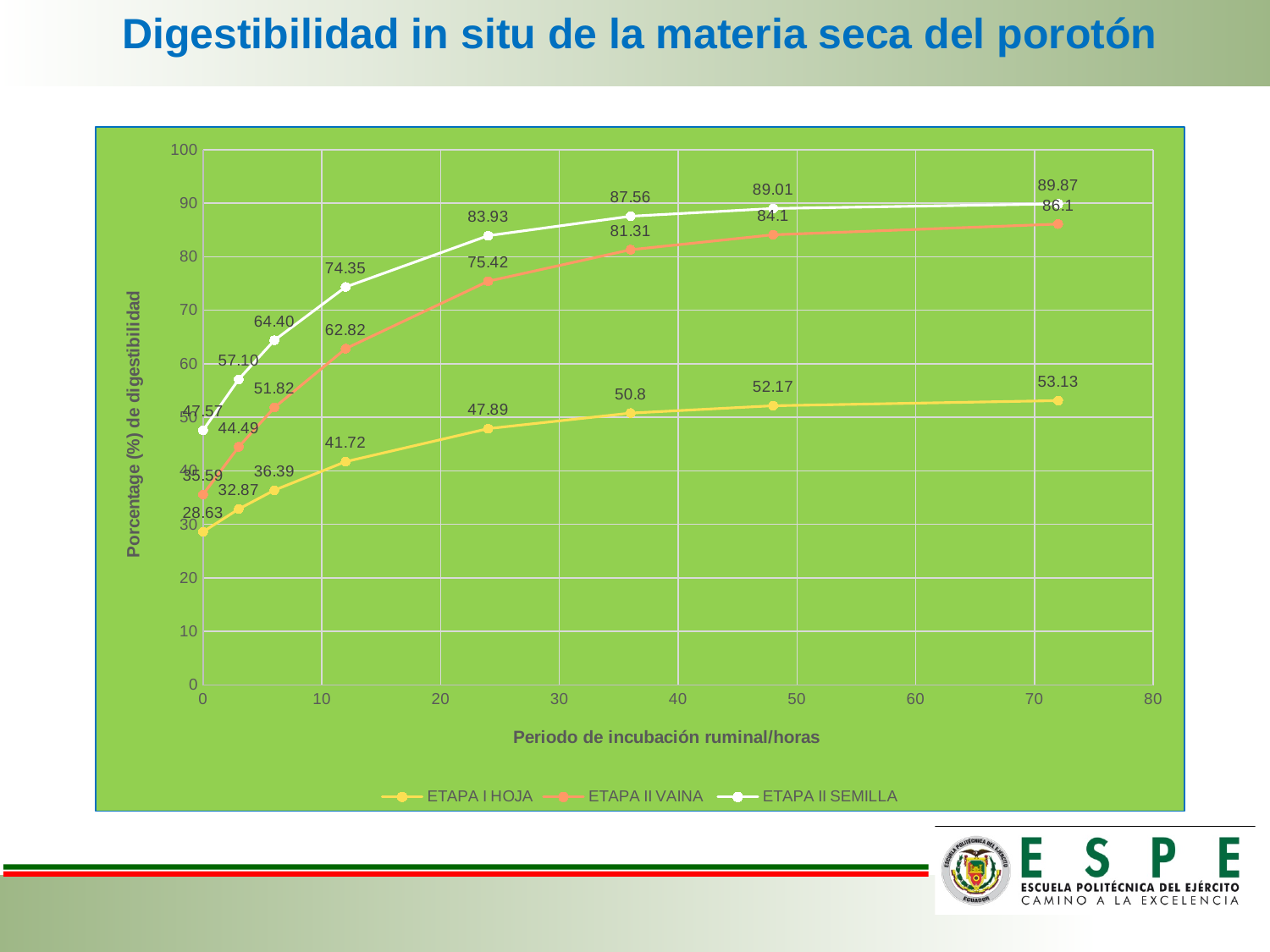
What is the value of ETAPA I HOJA at 0 hours of incubation? 28.63 At 0 hours, what is the difference between ETAPA II SEMILLA (47.57) and ETAPA I HOJA (28.63)? 18.94 Which series reaches the highest digestibility at the rightmost point? ETAPA II SEMILLA At 0 hours, which is larger: ETAPA II VAINA or ETAPA I HOJA? ETAPA II VAINA What type of chart is shown on the slide? line chart Do the values of ETAPA I HOJA rise or fall as the incubation period increases? rise What is the value of ETAPA II SEMILLA at 0 hours of incubation? 47.57 What is the title of the x axis? Periodo de incubación ruminal/horas What is the final (rightmost) value of the ETAPA II VAINA series? 86.1 How many series does the legend list? 3 Which series has the lowest digestibility at the rightmost point? ETAPA I HOJA What is the highest value reached by the ETAPA II SEMILLA series? 89.87